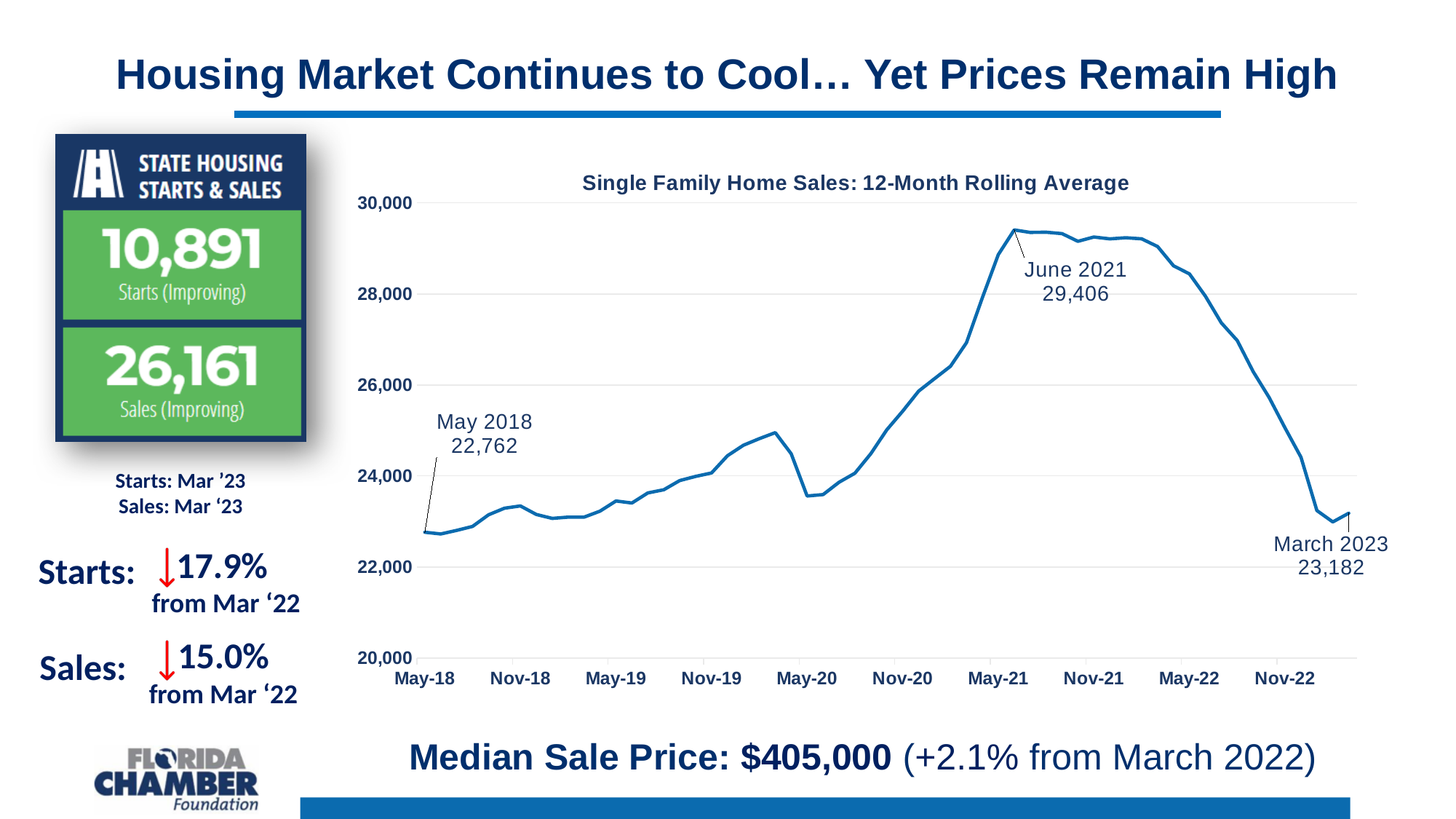
What is the difference between the June 2021 value and the May 2018 value? 6,644 What is the labeled value for May 2018 on the chart? 22,762 Is the value at May-20 greater or less than 24,000? less Which labeled point on the chart has the highest value? June 2021 What is the difference between the June 2021 value and the March 2023 value? 6,224 Is the value at Nov-21 greater or less than 28,000? greater What is the title of the chart? Single Family Home Sales: 12-Month Rolling Average Which is larger, the value for March 2023 or the value for May 2018? March 2023 Does the line rise or fall between June 2021 and March 2023? fall What is the labeled value for June 2021 on the chart? 29,406 What is the labeled value for March 2023 on the chart? 23,182 What type of chart is shown on the slide? line chart